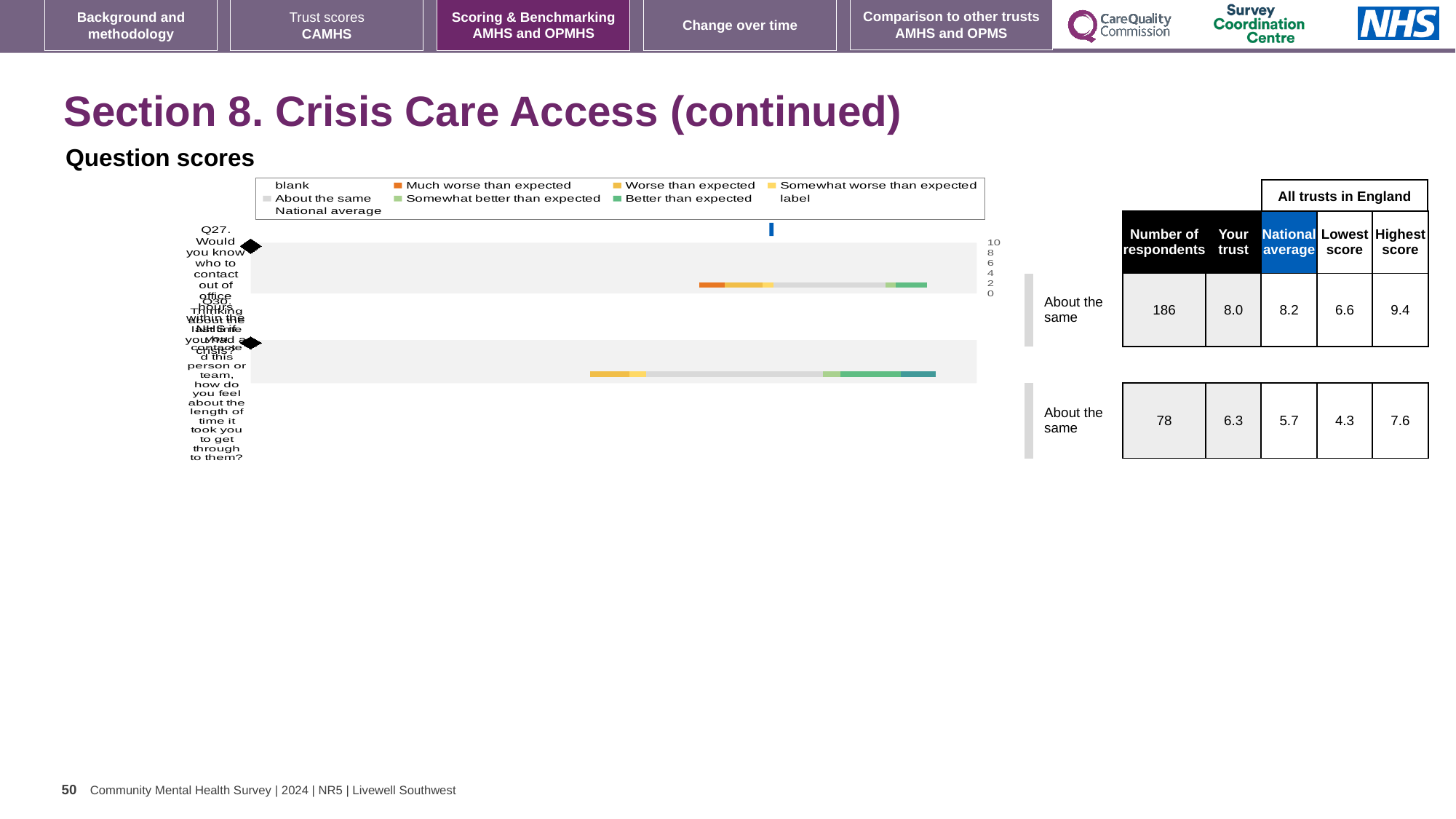
In the legend of the 'Question scores' chart, what colour marks 'Much worse than expected'? orange In the table beside the 'Question scores' chart, what is the 'Your trust' score for Q30? 6.3 In the table beside the 'Question scores' chart, how many respondents are listed for Q27? 186 What benchmark category is shown beside the Q30 bar in the 'Question scores' chart? About the same What benchmark category is shown beside the Q27 bar in the 'Question scores' chart? About the same How many entries does the legend of the 'Question scores' chart list? 9 In the table beside the 'Question scores' chart, what is the difference between the 'Your trust' score and the national average for Q30? 0.6 In the table beside the 'Question scores' chart, what is the national average for Q27? 8.2 In the table beside the 'Question scores' chart, what is the highest score for Q30? 7.6 How many questions (bars) are plotted in the 'Question scores' chart? 2 In the table beside the 'Question scores' chart, which question has the higher 'Your trust' score, Q27 or Q30? Q27 What kind of chart is shown under the heading 'Question scores'? bar chart